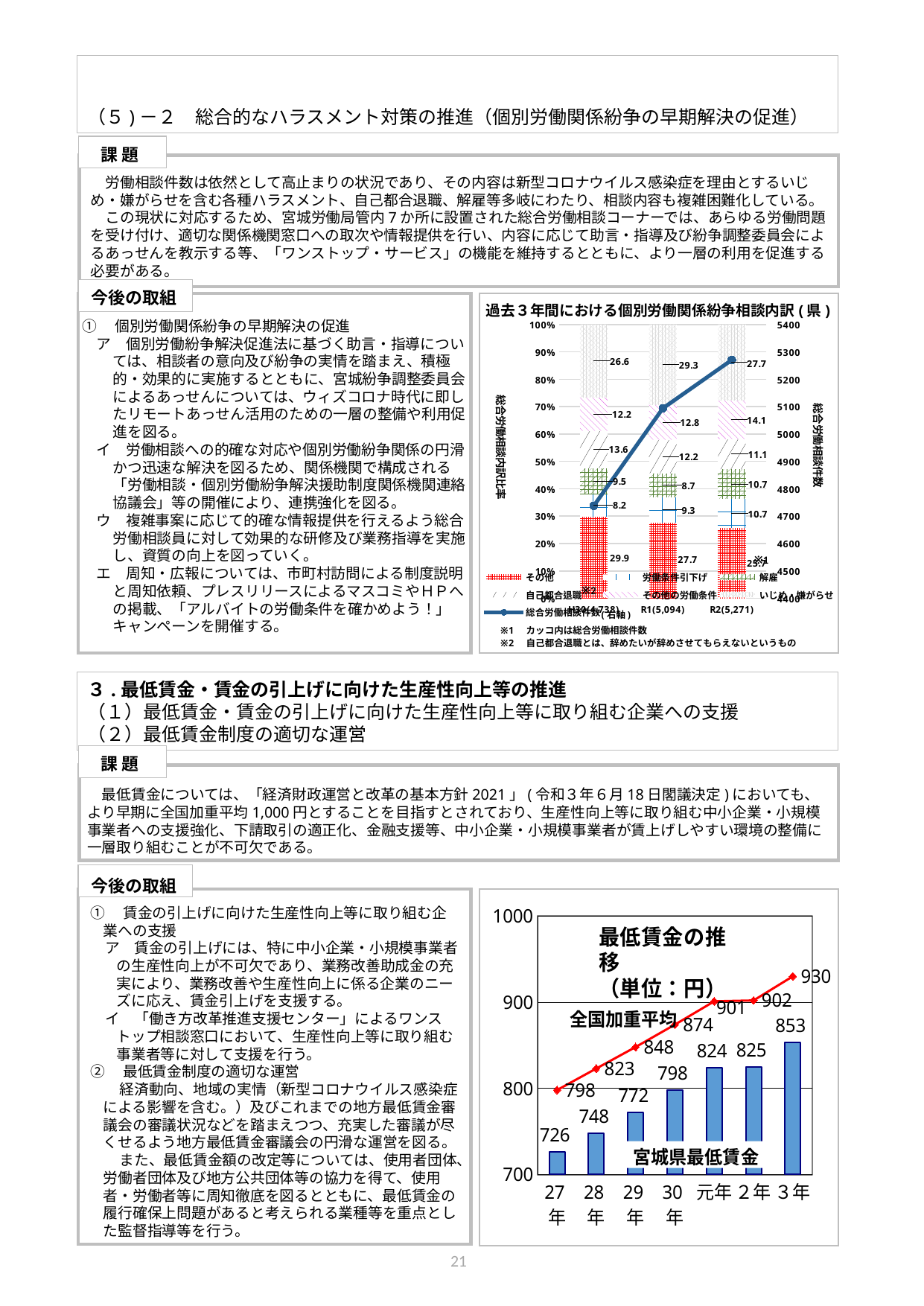
In the 過去３年間における個別労働関係紛争相談内訳 chart, what is the 総合労働相談件数 for R2? 5,271 In the 最低賃金の推移 chart, is the 宮城県最低賃金 for 元年 greater or less than 800? greater In the 最低賃金の推移 chart, what is the difference between the 全国加重平均 and the 宮城県最低賃金 in 3年? 77 In the 最低賃金の推移 chart, how many years are shown on the x axis? 7 In the 過去３年間における個別労働関係紛争相談内訳 chart, what is the difference in 総合労働相談件数 between R1 and H30? 356 In the 最低賃金の推移 chart, what is the 宮城県最低賃金 value for 30年? 798 In the 過去３年間における個別労働関係紛争相談内訳 chart, which year has the highest 総合労働相談件数? R2 In the 最低賃金の推移 chart, which year has the lowest 宮城県最低賃金? 27年 In the 最低賃金の推移 chart, does the 宮城県最低賃金 rise or fall from 27年 to 3年? rise In the 最低賃金の推移 chart, what is the 全国加重平均 value for 27年? 798 In the 最低賃金の推移 chart, what is the 宮城県最低賃金 value for 3年? 853 In the 過去３年間における個別労働関係紛争相談内訳 chart, how many entries does the legend list? 7